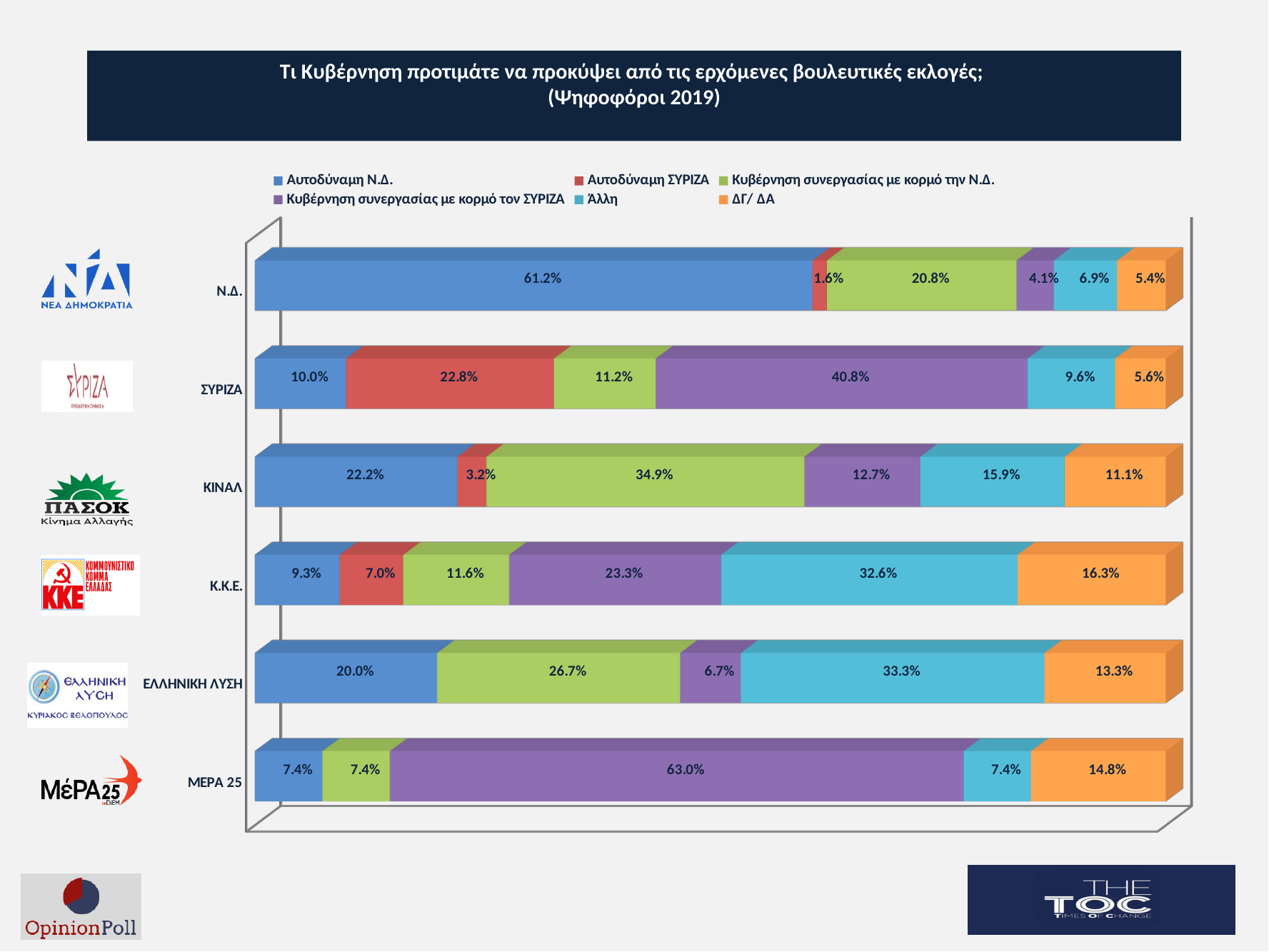
What is the value of Κυβέρνηση συνεργασίας με κορμό τον ΣΥΡΙΖΑ for ΜΕΡΑ 25 voters? 63.0% What kind of chart is shown on the slide? Stacked bar chart What is the value of Άλλη for Κ.Κ.Ε. voters? 32.6% Which party's voters have the highest value for ΔΓ/ ΔΑ? Κ.Κ.Ε. What is the value of Κυβέρνηση συνεργασίας με κορμό τον ΣΥΡΙΖΑ for ΣΥΡΙΖΑ voters? 40.8% Which series is shown in orange in the legend? ΔΓ/ ΔΑ Which party's voters have the highest value for Αυτοδύναμη Ν.Δ.? Ν.Δ. What is the value of Αυτοδύναμη Ν.Δ. for Ν.Δ. voters? 61.2% Which is larger: the Κυβέρνηση συνεργασίας με κορμό την Ν.Δ. value for ΚΙΝΑΛ voters or for ΕΛΛΗΝΙΚΗ ΛΥΣΗ voters? ΚΙΝΑΛ How many party categories are plotted on the chart? 6 How many series does the legend list? 6 What is the difference between the Κυβέρνηση συνεργασίας με κορμό τον ΣΥΡΙΖΑ value for ΣΥΡΙΖΑ voters and for ΚΙΝΑΛ voters? 28.1 percentage points